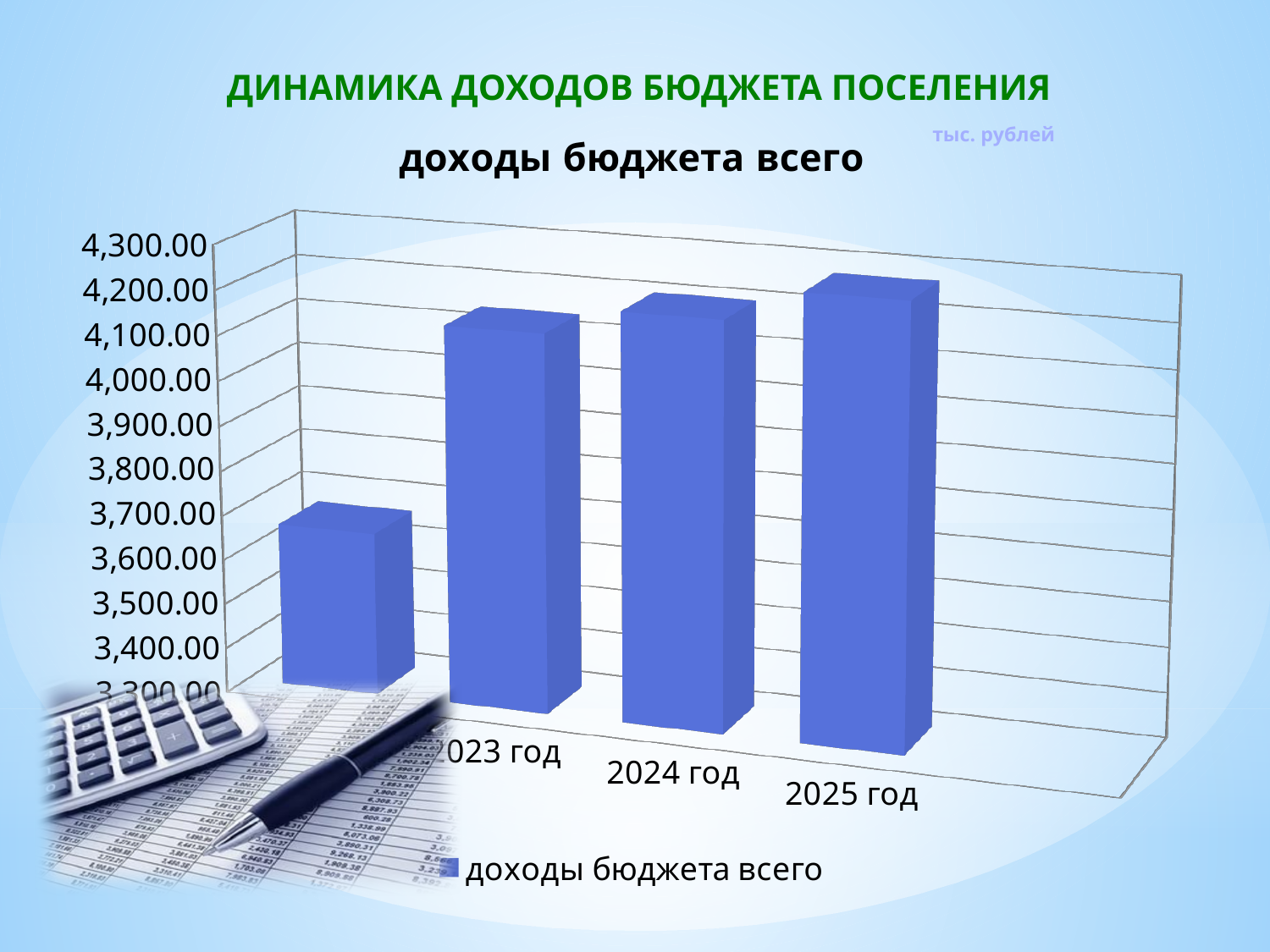
Which is larger, the value for 2025 год or the value for 2023 год? 2025 год What kind of chart is shown on the slide? bar chart Which year has the highest value in the chart? 2025 год Is the value for 2023 год greater or less than 4,000.00? greater Do the values rise or fall from left to right along the x axis? rise Is the value for 2024 год greater or less than 3,900.00? greater What is the title of the chart? доходы бюджета всего How many series does the legend list? 1 Is the value for 2025 год greater or less than 4,300.00? less How many bars are plotted in the chart? 4 What unit is indicated for the chart values on the slide? тыс. рублей